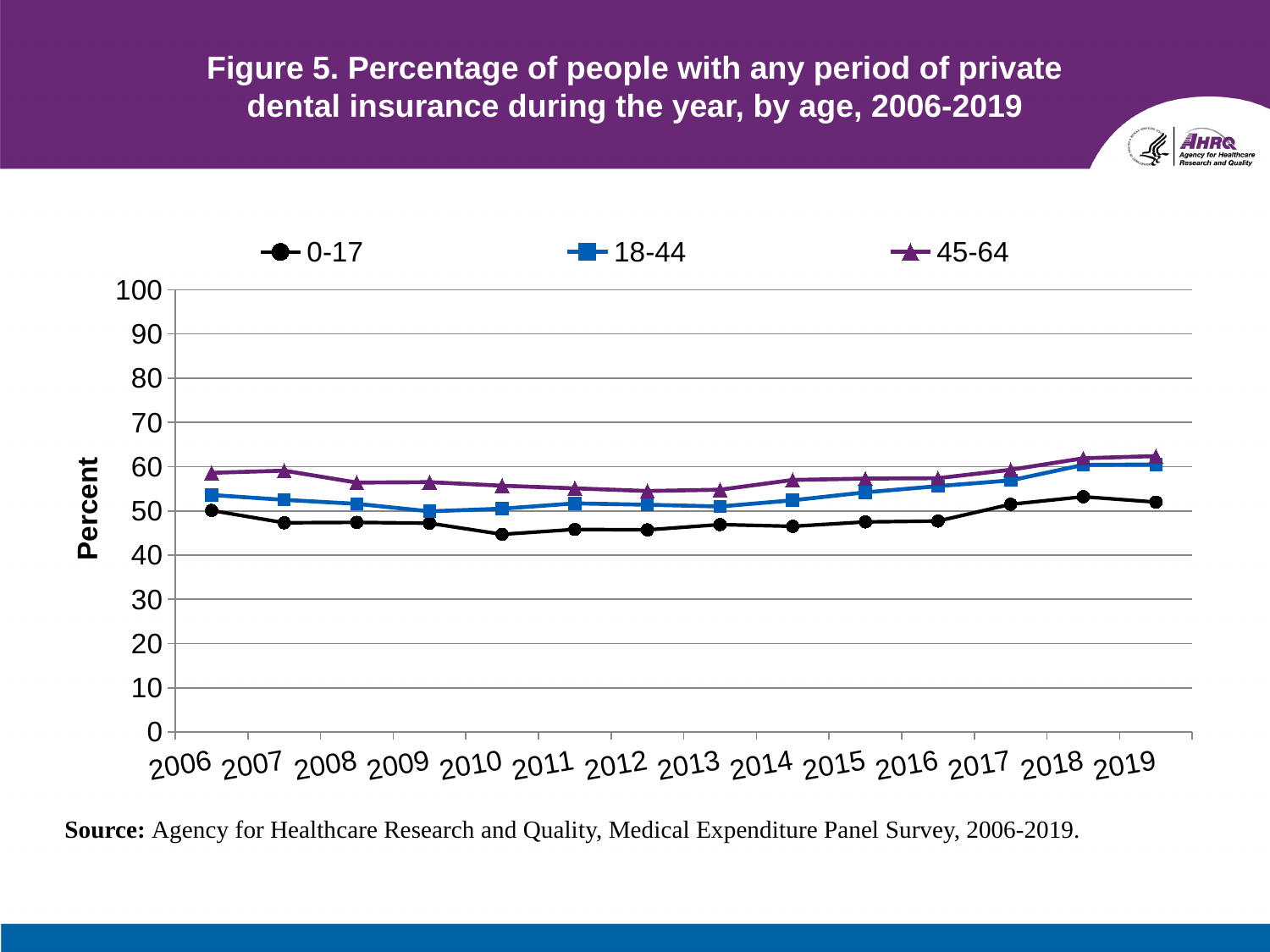
What kind of chart is shown on the slide? Line chart In 2006, which is larger: the value for the 45-64 group or the value for the 0-17 group? 45-64 Is the value for the 18-44 group in 2006 greater or less than 50? greater Is the value for the 45-64 group in 2018 greater or less than 60? greater How many years are plotted along the x axis? 14 Does the value for the 18-44 group rise or fall from 2013 to 2019? Rise Is the value for the 0-17 group in 2010 greater or less than 50? less How many series does the legend list? 3 Which age group has the highest percentage in 2019? 45-64 Which age group has the lowest percentage in 2006? 0-17 What is the label on the y axis? Percent Which marker shape is used for the 45-64 series in the legend? Triangle